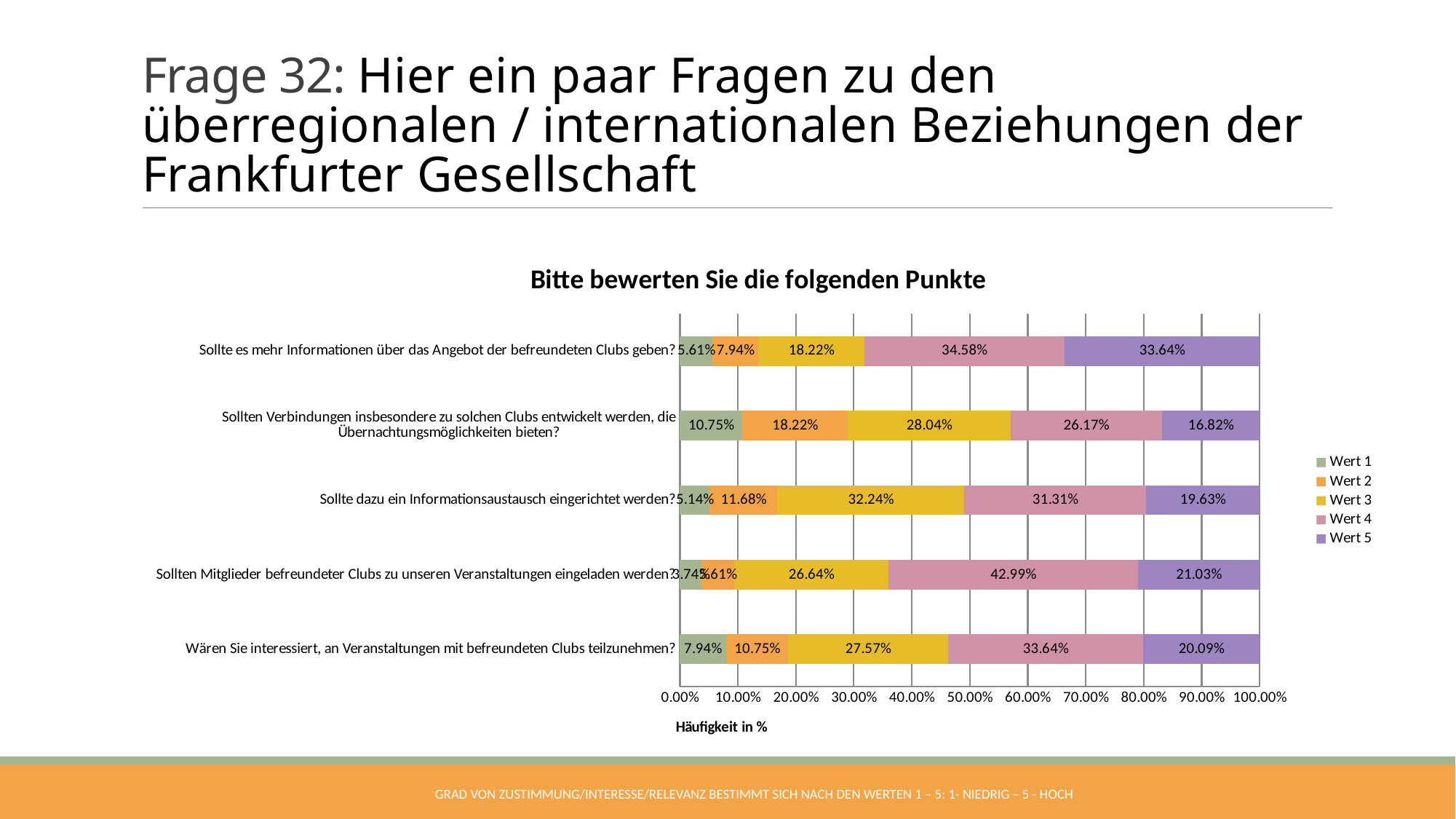
What is the Wert 5 value for "Sollte es mehr Informationen über das Angebot der befreundeten Clubs geben?"? 33.64% What is the Wert 1 value for "Sollten Verbindungen insbesondere zu solchen Clubs entwickelt werden, die Übernachtungsmöglichkeiten bieten?"? 10.75% What is the difference between the Wert 3 values for "Sollten Verbindungen insbesondere zu solchen Clubs entwickelt werden, die Übernachtungsmöglichkeiten bieten?" and "Sollte es mehr Informationen über das Angebot der befreundeten Clubs geben?"? 9.82% What is the Wert 4 value for "Wären Sie interessiert, an Veranstaltungen mit befreundeten Clubs teilzunehmen?"? 33.64% How many series does the legend list? 5 What kind of chart is shown on the slide? stacked bar chart Which category has the highest Wert 4 value? Sollten Mitglieder befreundeter Clubs zu unseren Veranstaltungen eingeladen werden? What is the Wert 3 value for "Sollte dazu ein Informationsaustausch eingerichtet werden?"? 32.24% Which is larger: the Wert 2 value for "Sollte dazu ein Informationsaustausch eingerichtet werden?" or the Wert 2 value for "Wären Sie interessiert, an Veranstaltungen mit befreundeten Clubs teilzunehmen?"? Sollte dazu ein Informationsaustausch eingerichtet werden? Which category has the lowest Wert 5 value? Sollten Verbindungen insbesondere zu solchen Clubs entwickelt werden, die Übernachtungsmöglichkeiten bieten? How many categories (questions) are plotted on the chart? 5 What is the title of the chart? Bitte bewerten Sie die folgenden Punkte